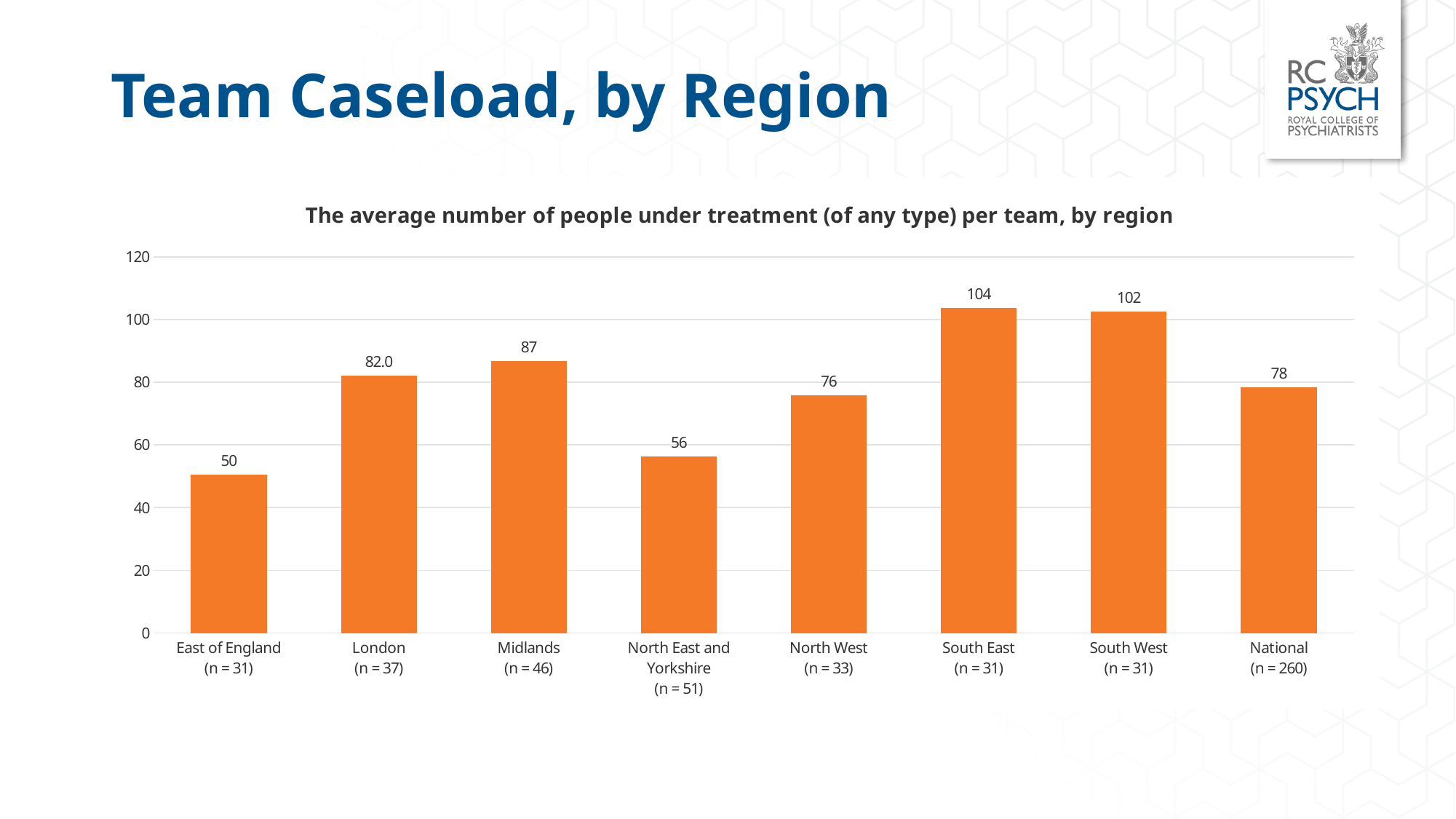
What is the title of the chart? The average number of people under treatment (of any type) per team, by region Which is larger, the value for North West or the value for London? London Which region has the highest average number of people under treatment per team? South East What kind of chart is shown on the slide? Bar chart What is the average number of people under treatment per team for London? 82.0 How many bars are shown in the chart? 8 What is the difference between the values for the Midlands and North East and Yorkshire? 31 What is the National average number of people under treatment per team? 78 What is the sample size (n) shown for the National bar? 260 Which region has the lowest average number of people under treatment per team? East of England What is the value shown for the South East? 104 Is the value for South West greater or less than 100? greater